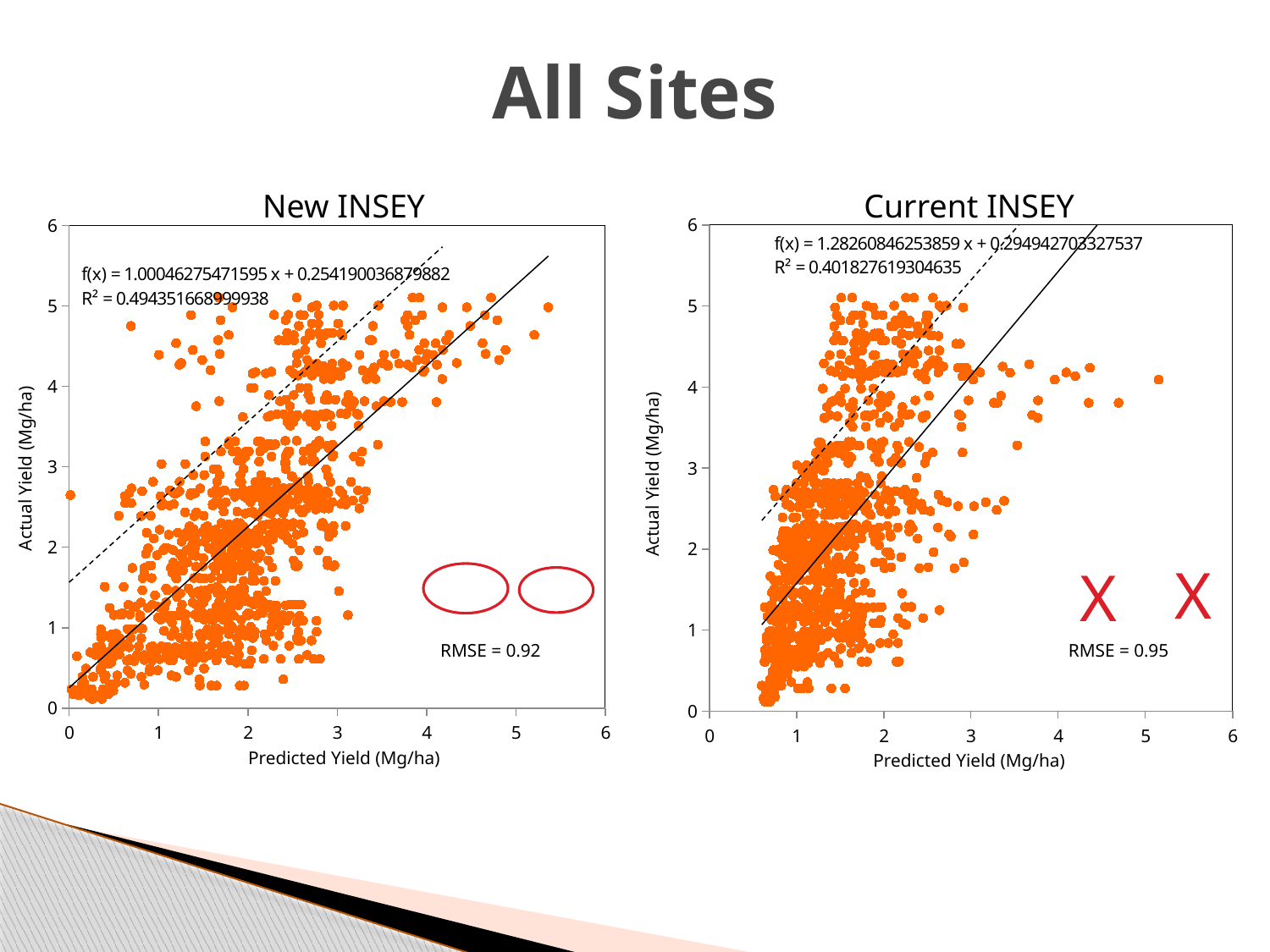
Which chart has the higher R² value, "New INSEY" or "Current INSEY"? New INSEY What kind of chart is the "New INSEY" chart? scatter chart In the "Current INSEY" chart, what is the slope of the fitted line f(x)? 1.28260846253859 What is the difference between the RMSE of the "Current INSEY" chart and the RMSE of the "New INSEY" chart? 0.03 What is the x-axis label of the "Current INSEY" chart? Predicted Yield (Mg/ha) What is the y-axis label of the "New INSEY" chart? Actual Yield (Mg/ha) In the "New INSEY" chart, what is the intercept of the fitted line f(x)? 0.254190036879882 In the "Current INSEY" chart, what is the RMSE value shown? RMSE = 0.95 In the "New INSEY" chart, what is the RMSE value shown? RMSE = 0.92 In the "Current INSEY" chart, what is the R² value shown? 0.401827619304635 In the "New INSEY" chart, what is the R² value shown? 0.494351668999938 Which chart has the lower RMSE, "New INSEY" or "Current INSEY"? New INSEY